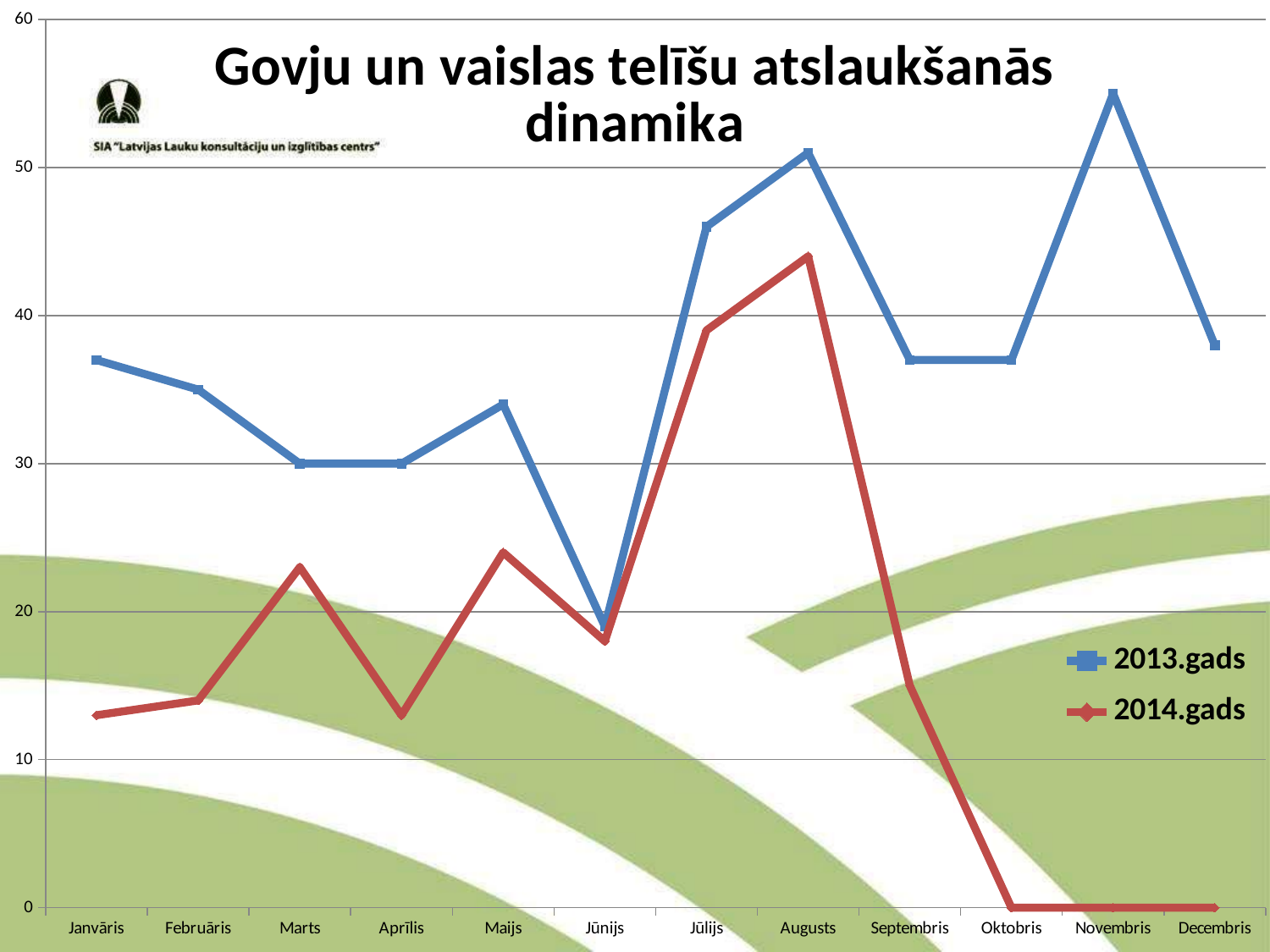
Which series has the larger value in Maijs, 2013.gads or 2014.gads? 2013.gads In which month is the 2013.gads series highest? Novembris How many series does the legend list? 2 What is the value for 2013.gads in Marts? 30 What is the value for 2014.gads in Oktobris? 0 How many months are shown along the x axis? 12 Is the value for 2014.gads in Janvāris greater or less than 20? less In which month is the 2014.gads series highest? Augusts In which month is the 2013.gads series lowest? Jūnijs Is the value for 2013.gads in Jūlijs greater or less than 40? greater Does the 2014.gads series rise or fall from Augusts to Decembris? fall What kind of chart is shown on the slide? line chart